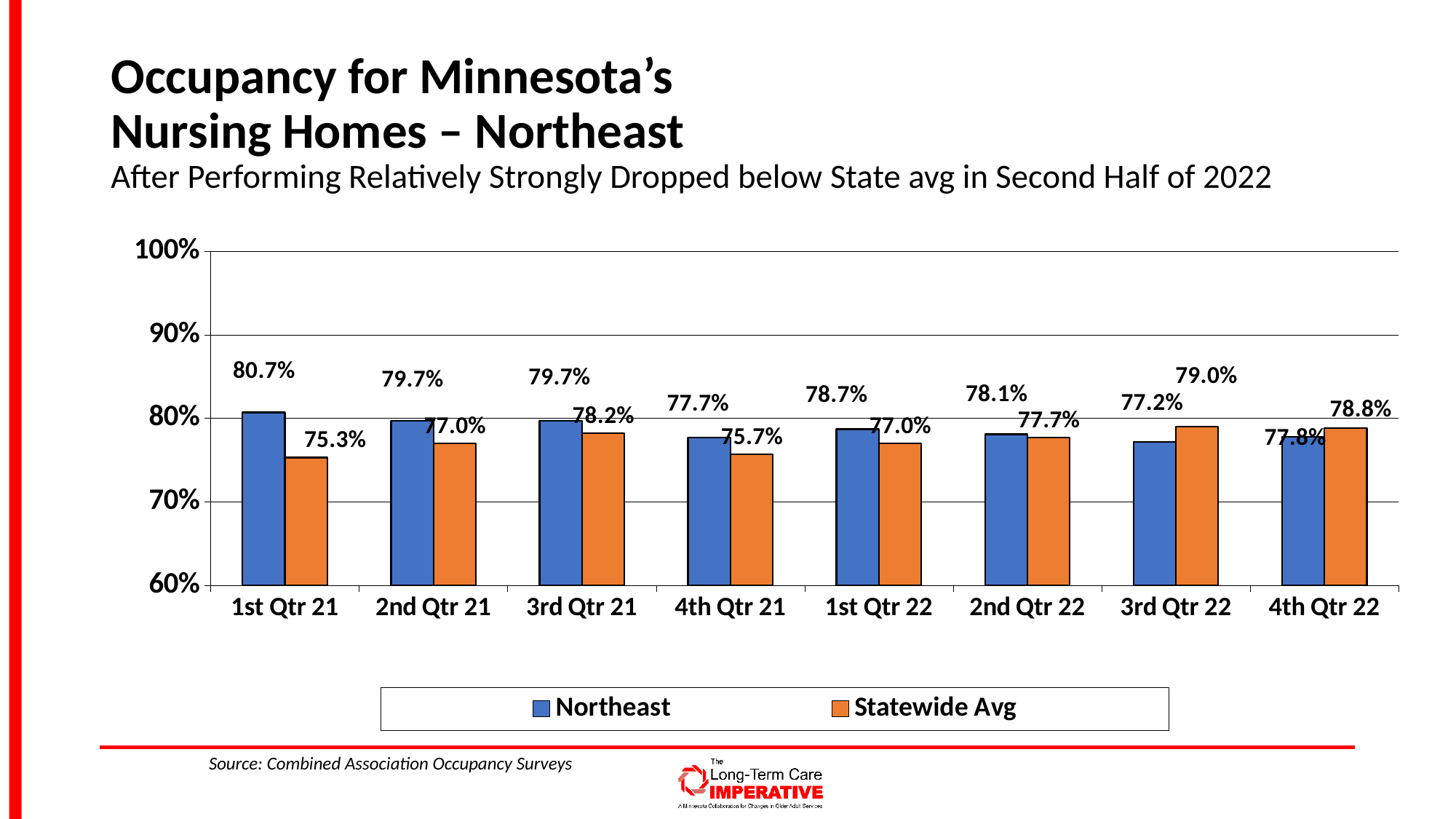
In which quarter is the Northeast occupancy highest? 1st Qtr 21 What is the Northeast occupancy value for 1st Qtr 21? 80.7% What is the Statewide Avg occupancy value for 4th Qtr 22? 78.8% What kind of chart is shown on the slide? bar chart In which quarter is the Statewide Avg occupancy lowest? 1st Qtr 21 Is the Northeast value for 4th Qtr 21 greater or less than 80%? less How many series does the legend list? 2 Does the Northeast occupancy generally rise or fall from 1st Qtr 21 to 4th Qtr 22? fall How many quarters are shown on the x axis? 8 Which is larger in 3rd Qtr 22, the Northeast value or the Statewide Avg value? Statewide Avg What is the Statewide Avg value for 3rd Qtr 21? 78.2% What is the difference between the Northeast and Statewide Avg values in 1st Qtr 21? 5.4%